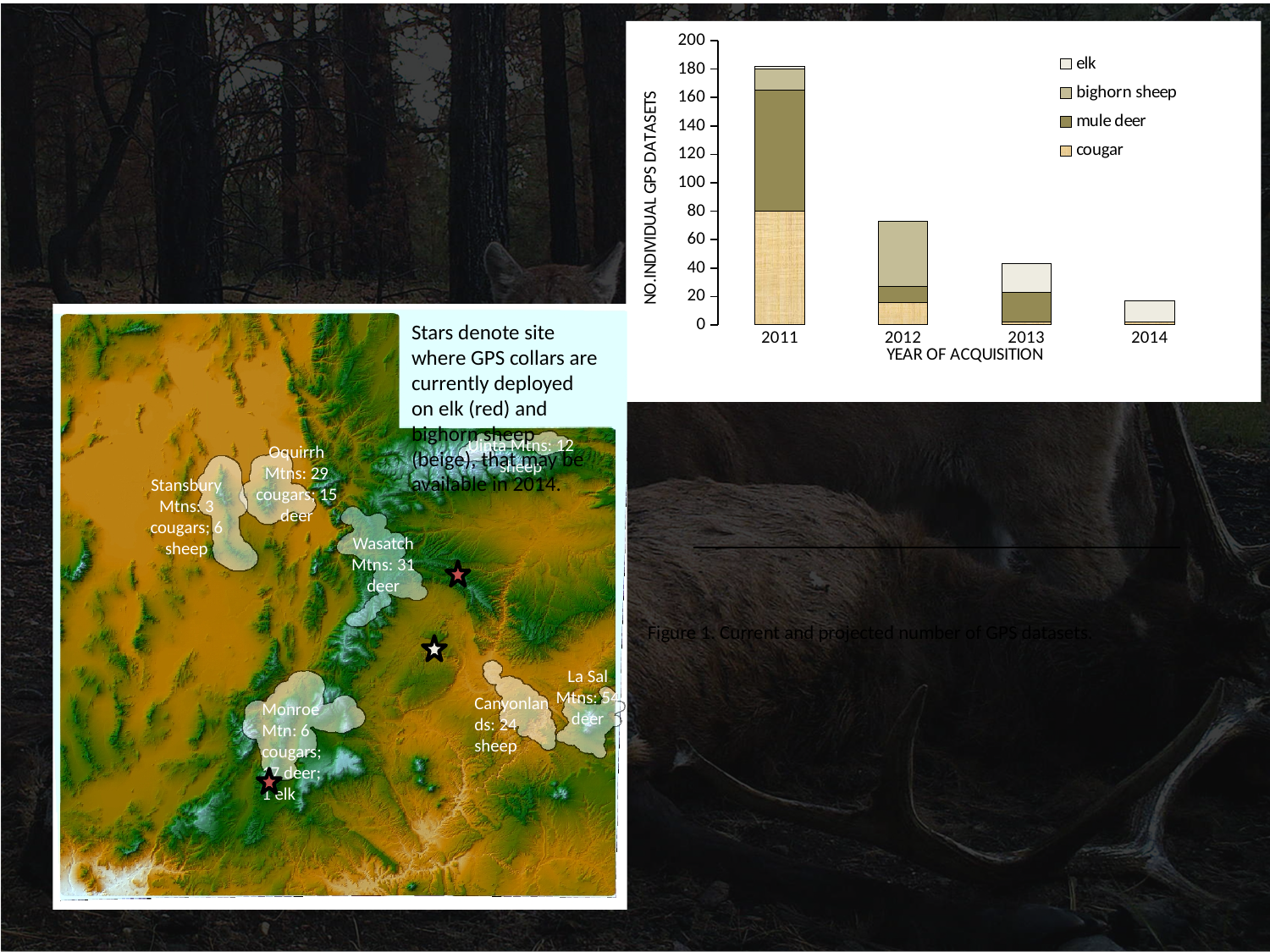
Which year has a larger total of GPS datasets, 2012 or 2013? 2012 Which year has the lowest total number of individual GPS datasets? 2014 Is the total number of GPS datasets for 2011 greater or less than 160? greater Which year has the highest total number of individual GPS datasets? 2011 How many series does the chart legend list? 4 Is the total number of GPS datasets for 2014 greater or less than 20? less Do the total numbers of GPS datasets rise or fall from 2011 to 2014? fall How many years are shown on the x axis of the chart? 4 What kind of chart is shown on the slide? stacked bar chart What is the label of the chart's x axis? YEAR OF ACQUISITION Is the total number of GPS datasets for 2012 greater or less than 80? less Which series is listed first in the chart legend? elk